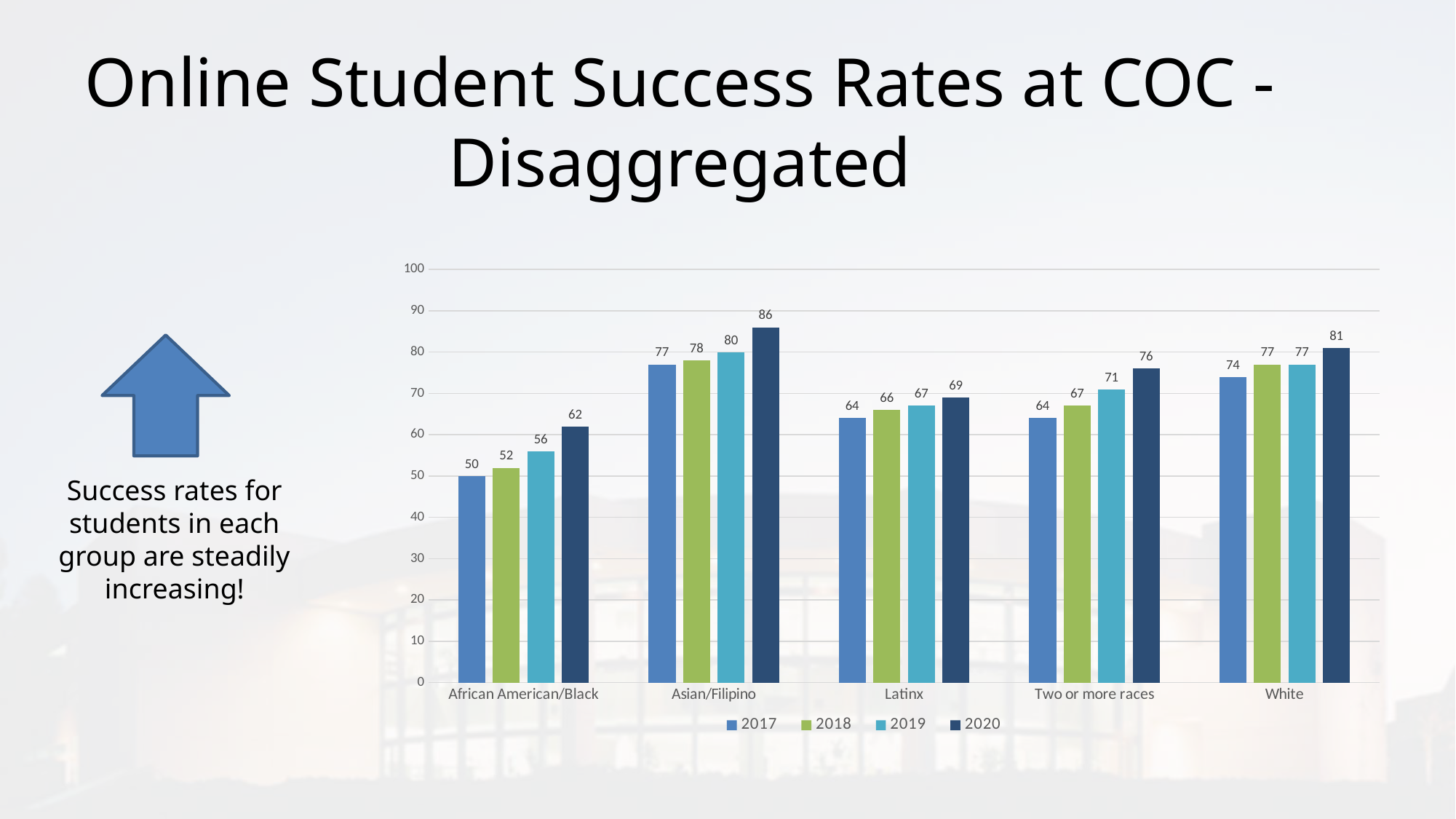
What is the difference between the 2020 and 2017 values for African American/Black? 12 What kind of chart is shown on the slide? Bar chart How many categories are shown on the x axis? 5 Which is larger, the 2018 value for Latinx or the 2018 value for Two or more races? Two or more races What is the 2019 value for Two or more races? 71 What is the 2017 value for African American/Black? 50 What is the 2020 value for Asian/Filipino? 86 Do the values for White rise or fall from 2017 to 2020? Rise How many series does the legend list? 4 Which years are listed in the legend? 2017, 2018, 2019, 2020 Which category has the highest 2020 value? Asian/Filipino Which category has the lowest 2017 value? African American/Black